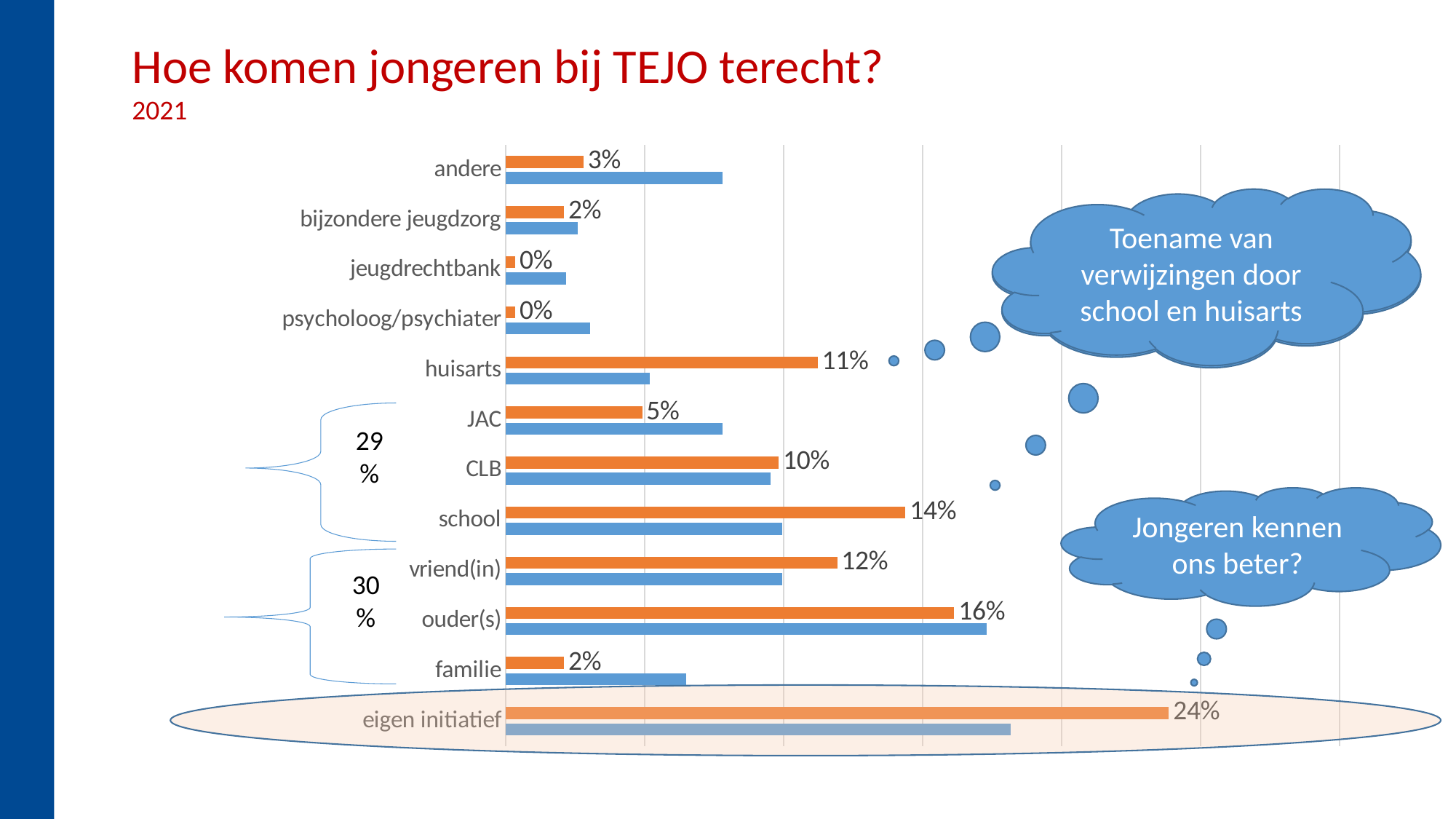
What kind of chart is shown on the slide? bar chart Which has the larger labelled orange value, 'CLB' or 'vriend(in)'? vriend(in) What is the labelled value for 'familie' in the orange series? 2% Which category has the highest labelled value in the orange series? eigen initiatief What is the difference between the labelled orange values for 'ouder(s)' and 'school'? 2% What is the labelled value for 'eigen initiatief' in the orange series? 24% How many categories are shown on the chart? 12 What is the title of the slide? Hoe komen jongeren bij TEJO terecht? What is the labelled value for 'huisarts' in the orange series? 11% What is the labelled value for 'school' in the orange series? 14% What is the difference between the labelled orange values for 'eigen initiatief' and 'vriend(in)'? 12% What is the labelled value for 'JAC' in the orange series? 5%